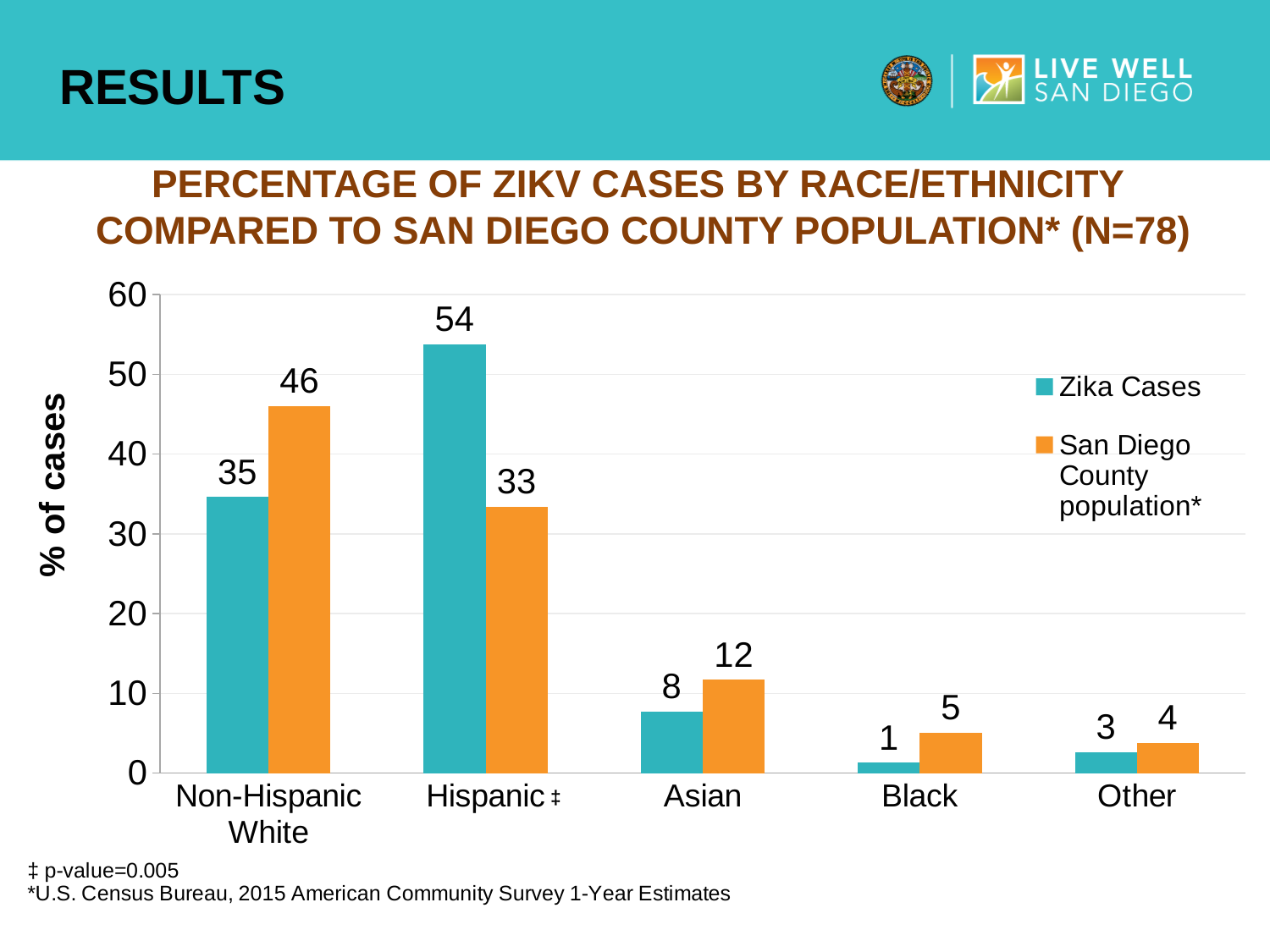
What is the difference between the Zika Cases value and the San Diego County population value for Hispanic? 21 What is the Zika Cases value for Hispanic? 54 Which race/ethnicity category has the highest Zika Cases value? Hispanic How many series does the legend list? 2 For Non-Hispanic White, which is larger: the Zika Cases value or the San Diego County population value? San Diego County population Which race/ethnicity category has the lowest Zika Cases value? Black What is the San Diego County population value for Non-Hispanic White? 46 What kind of chart is shown on the slide? Bar chart How many race/ethnicity categories are shown on the x axis? 5 What is the Zika Cases value for Asian? 8 Is the Zika Cases value for Hispanic greater or less than 50? greater What is the label of the y axis? % of cases